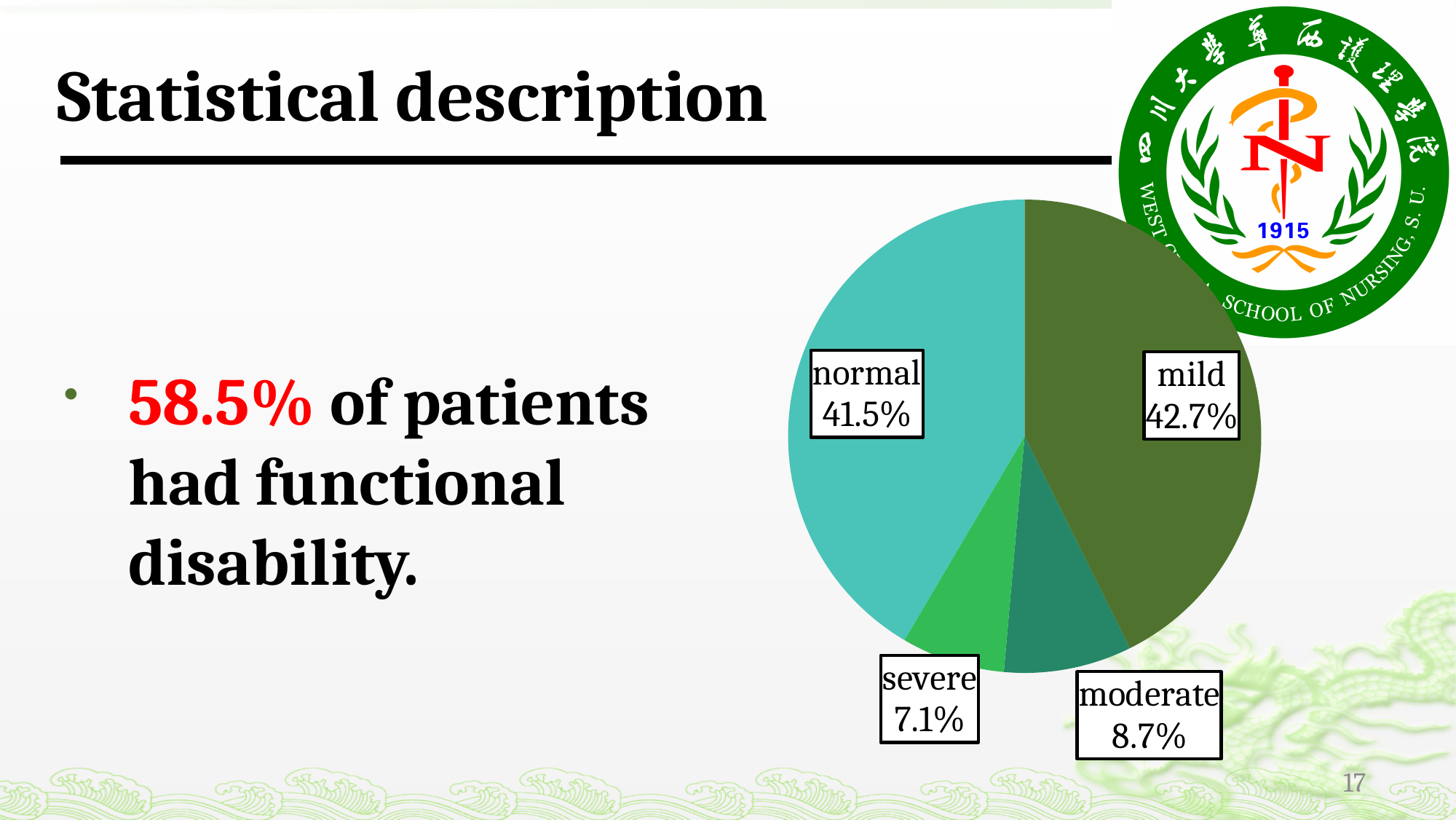
Which slice of the pie chart is the largest? mild How many slices does the pie chart have? 4 What percentage of the pie chart is labelled "severe"? 7.1% Which slice is larger, "moderate" or "severe"? moderate What is the difference in percentage points between the "mild" and "normal" slices? 1.2% What percentage of the pie chart is labelled "mild"? 42.7% What percentage of the pie chart is labelled "moderate"? 8.7% What is the combined share of the "mild", "moderate" and "severe" slices? 58.5% What percentage of the pie chart is labelled "normal"? 41.5% What kind of chart is shown on the slide? pie chart Which slice of the pie chart is the smallest? severe What is the difference in percentage points between the "moderate" and "severe" slices? 1.6%